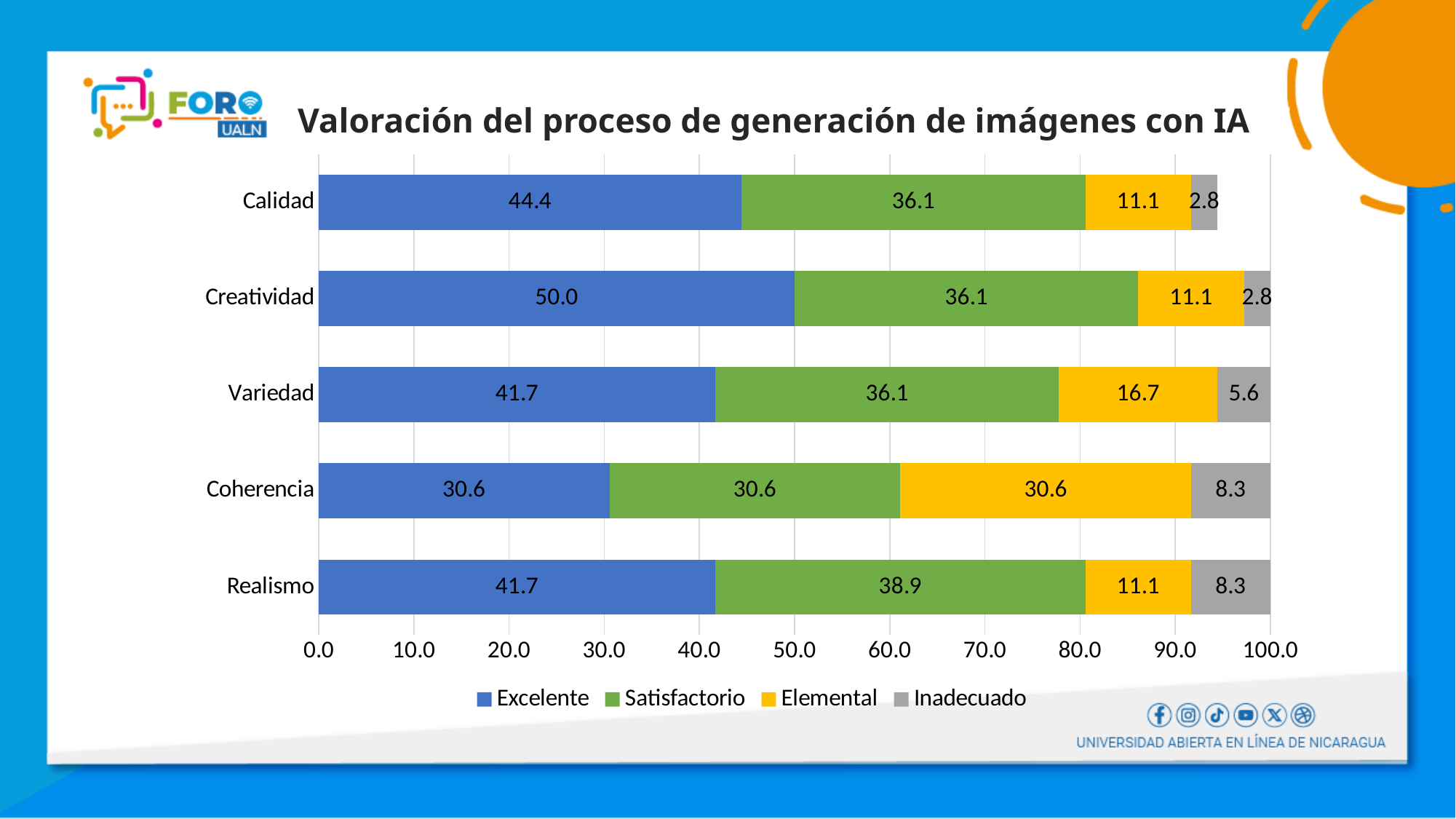
What is the difference between the Excelente values for Creatividad and Coherencia? 19.4 What is the Inadecuado value for Coherencia? 8.3 What is the Elemental value for Variedad? 16.7 What is the total of the stacked bar for Realismo? 100.0 Which category has the highest Excelente value? Creatividad What is the Satisfactorio value for Realismo? 38.9 Which is larger, the Elemental value for Coherencia or the Elemental value for Calidad? Coherencia Which category has the lowest Excelente value? Coherencia What is the Excelente value for Creatividad? 50.0 How many series does the legend list? 4 How many categories are shown on the y axis? 5 What kind of chart is shown on the slide? Stacked bar chart